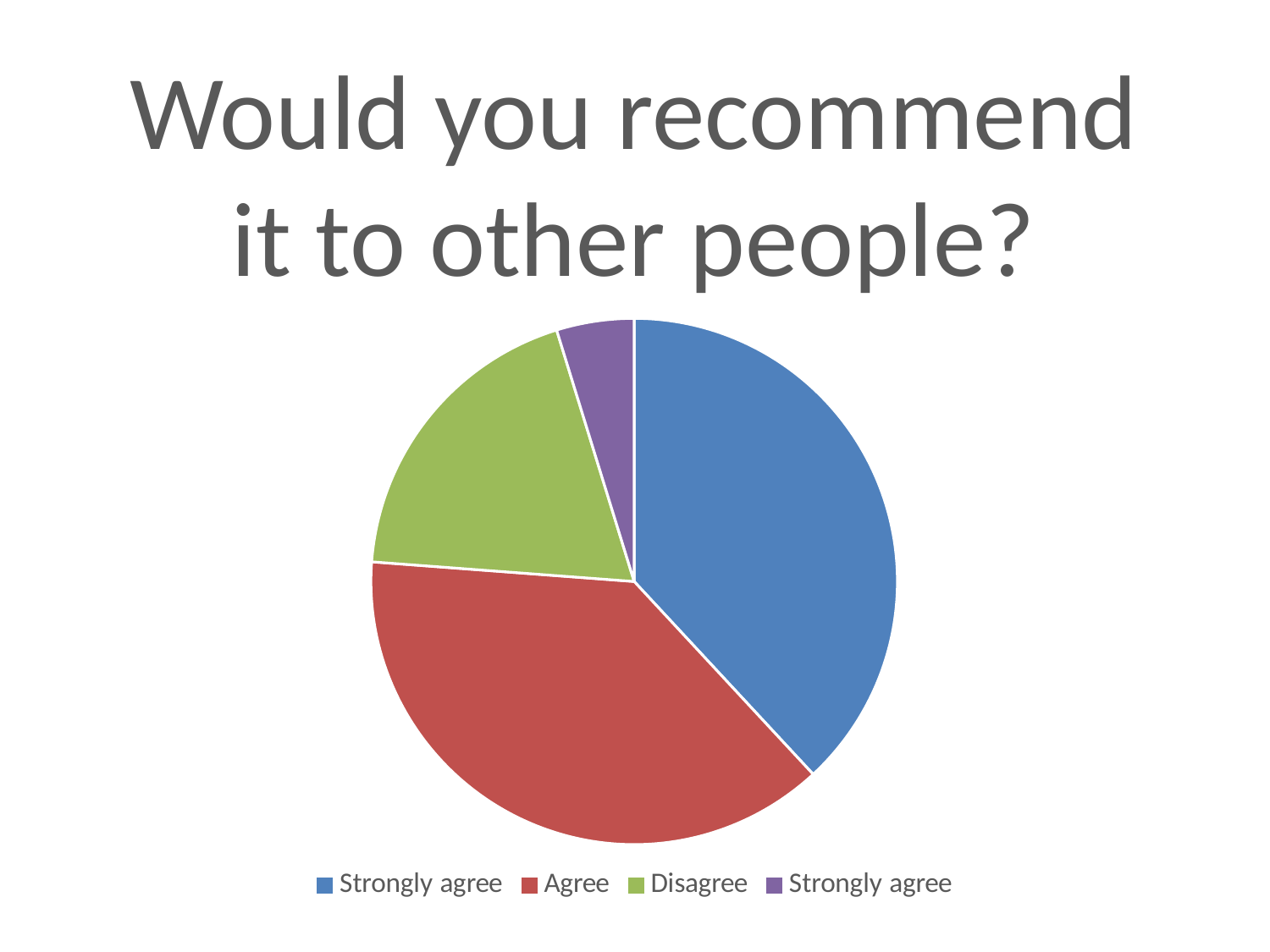
How many entries does the legend list? 4 Which is larger, the Disagree slice or the purple slice? Disagree Which is larger, the Agree slice or the Disagree slice? Agree Which colour is the smallest slice of the pie chart? purple What colour is the Agree slice in the pie chart? red How many slices does the pie chart have? 4 What is the title of the chart on the slide? Would you recommend it to other people? Which is larger, the blue slice or the Disagree slice? the blue slice Which legend label appears twice in the legend? Strongly agree What kind of chart is shown on the slide? pie chart